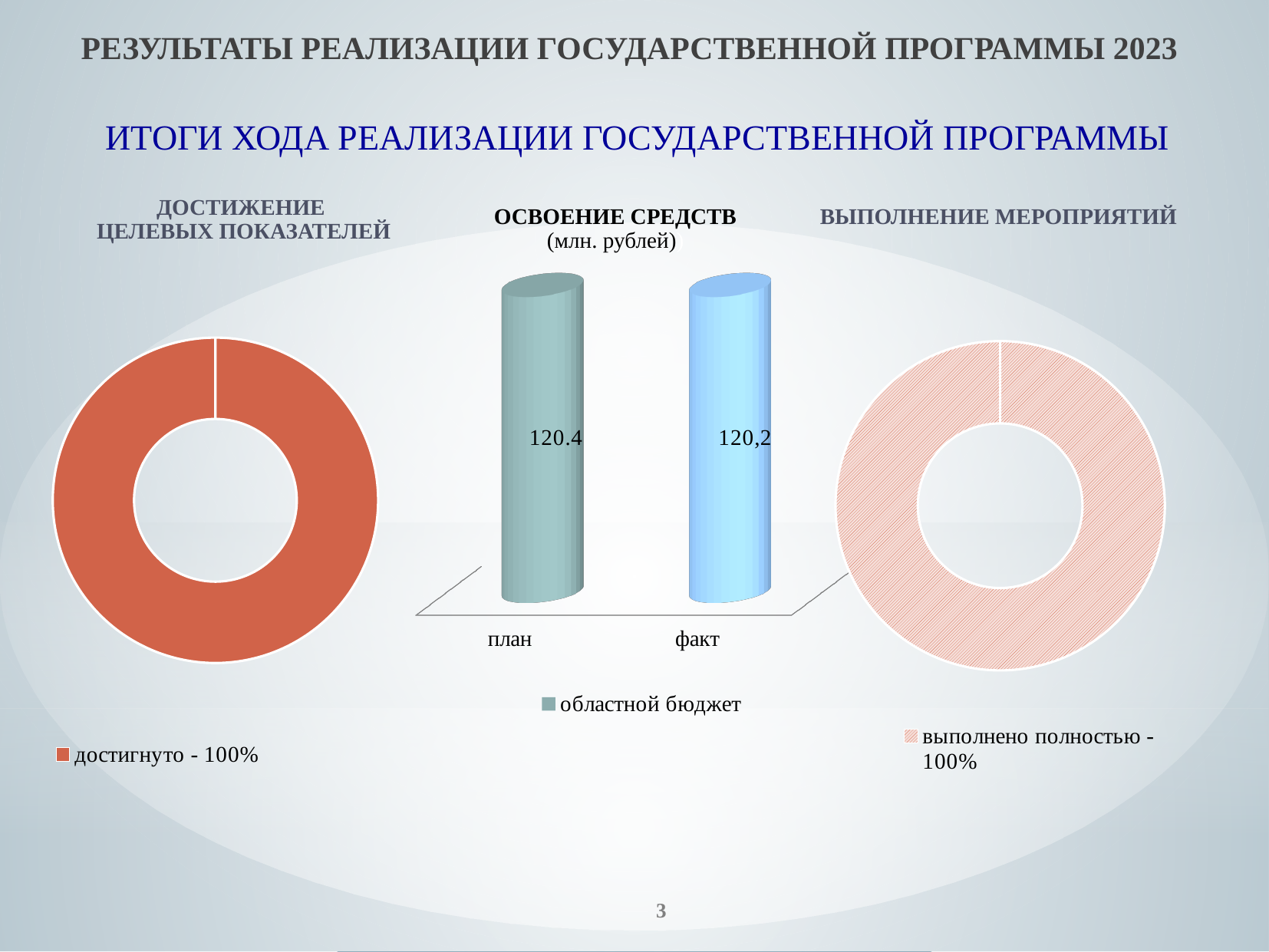
In the ОСВОЕНИЕ СРЕДСТВ chart, what is the value for план? 120.4 In the ОСВОЕНИЕ СРЕДСТВ chart, what is the difference between the план and факт values? 0.2 What kind of chart is the ОСВОЕНИЕ СРЕДСТВ chart? bar chart In the ОСВОЕНИЕ СРЕДСТВ chart, what is the value for факт? 120,2 How many categories are shown in the ОСВОЕНИЕ СРЕДСТВ chart? 2 How many series does the legend of the ОСВОЕНИЕ СРЕДСТВ chart list? 1 In the ОСВОЕНИЕ СРЕДСТВ chart, do the values rise or fall from план to факт? fall In the ОСВОЕНИЕ СРЕДСТВ chart, which category has the lowest value? факт What kind of chart is the ДОСТИЖЕНИЕ ЦЕЛЕВЫХ ПОКАЗАТЕЛЕЙ chart on the left? doughnut chart In the ОСВОЕНИЕ СРЕДСТВ chart, which category has the higher value, план or факт? план In the ВЫПОЛНЕНИЕ МЕРОПРИЯТИЙ chart on the right, what share does the 'выполнено полностью' slice represent? 100% What series name is listed in the legend of the ОСВОЕНИЕ СРЕДСТВ chart? областной бюджет